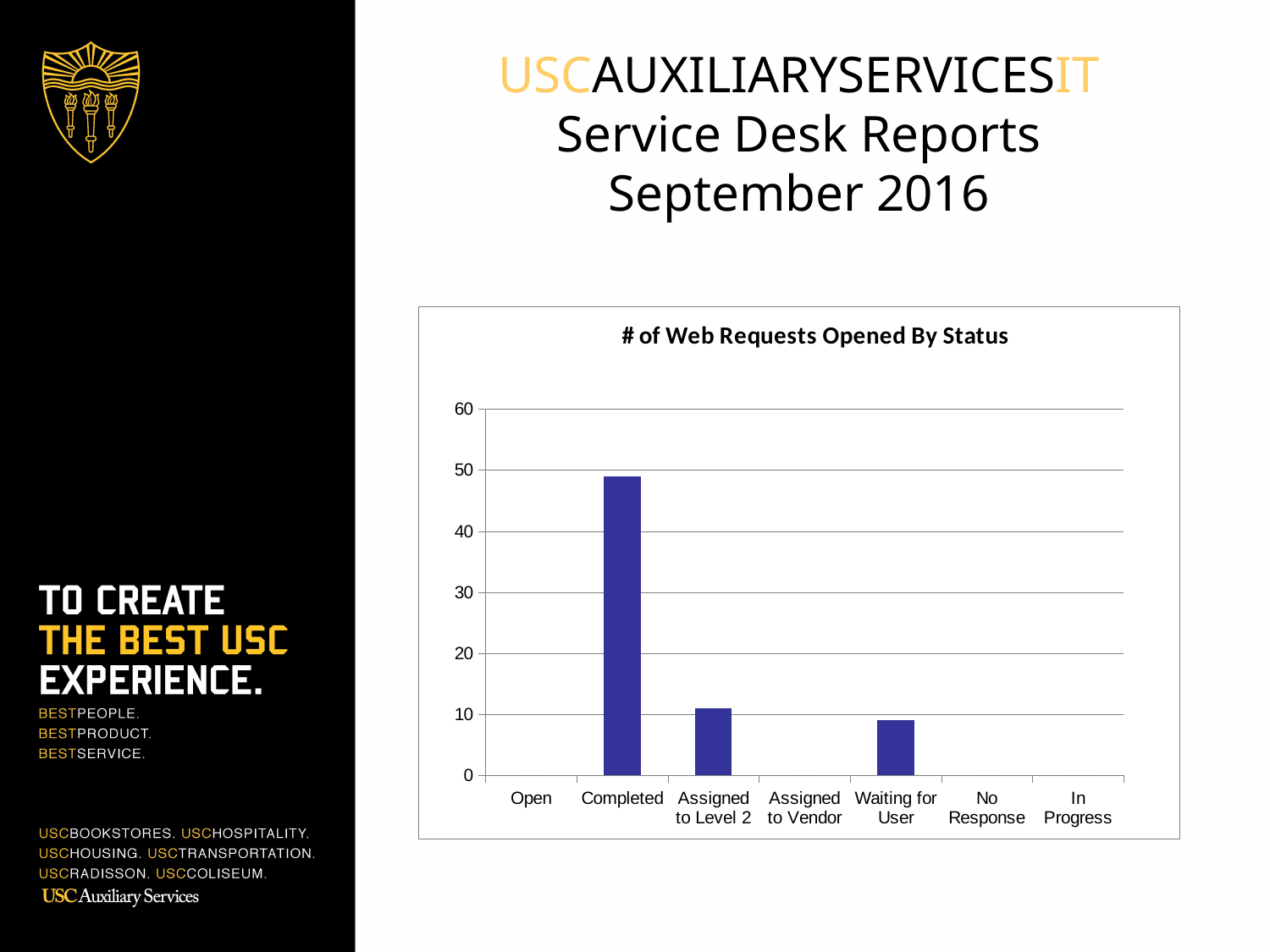
Which is larger, the value for Assigned to Level 2 or the value for Waiting for User? Assigned to Level 2 What kind of chart is shown on the slide? bar chart Which is larger, the value for Completed or the value for Waiting for User? Completed Is the value for Assigned to Level 2 greater or less than 20? less Which status has the highest number of web requests opened? Completed Is the value for Completed greater or less than 30? greater Is the value for Completed greater or less than 40? greater Which is larger, the value for Completed or the value for Assigned to Level 2? Completed What is the title of the chart? # of Web Requests Opened By Status What is the highest value shown on the y axis of the chart? 60 How many status categories are shown on the x axis of the chart? 7